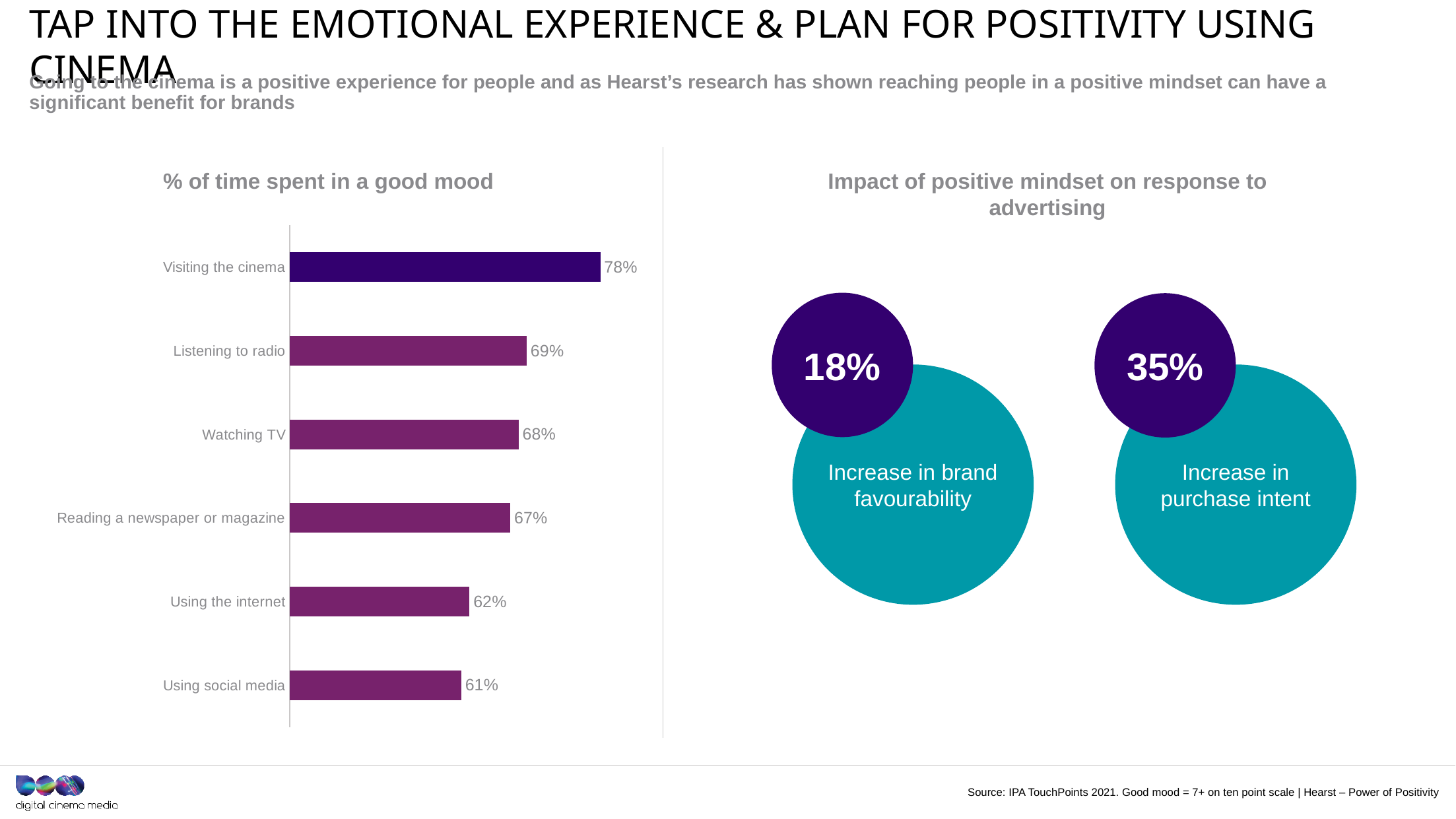
In the '% of time spent in a good mood' chart, which activity has the lowest value? Using social media In the '% of time spent in a good mood' chart, which bar is coloured differently from the others? Visiting the cinema In the '% of time spent in a good mood' chart, what is the value for Reading a newspaper or magazine? 67% In the '% of time spent in a good mood' chart, which is larger: Watching TV or Using the internet? Watching TV How many activities are shown in the '% of time spent in a good mood' chart? 6 In the '% of time spent in a good mood' chart, what is the value for Using the internet? 62% In the '% of time spent in a good mood' chart, which activity has the highest value? Visiting the cinema In the '% of time spent in a good mood' chart, what is the value for Visiting the cinema? 78% In the '% of time spent in a good mood' chart, what is the difference between Listening to radio and Using the internet? 7% In the '% of time spent in a good mood' chart, what is the difference between Visiting the cinema and Using social media? 17% What type of chart is '% of time spent in a good mood'? Bar chart In the '% of time spent in a good mood' chart, what is the value for Listening to radio? 69%